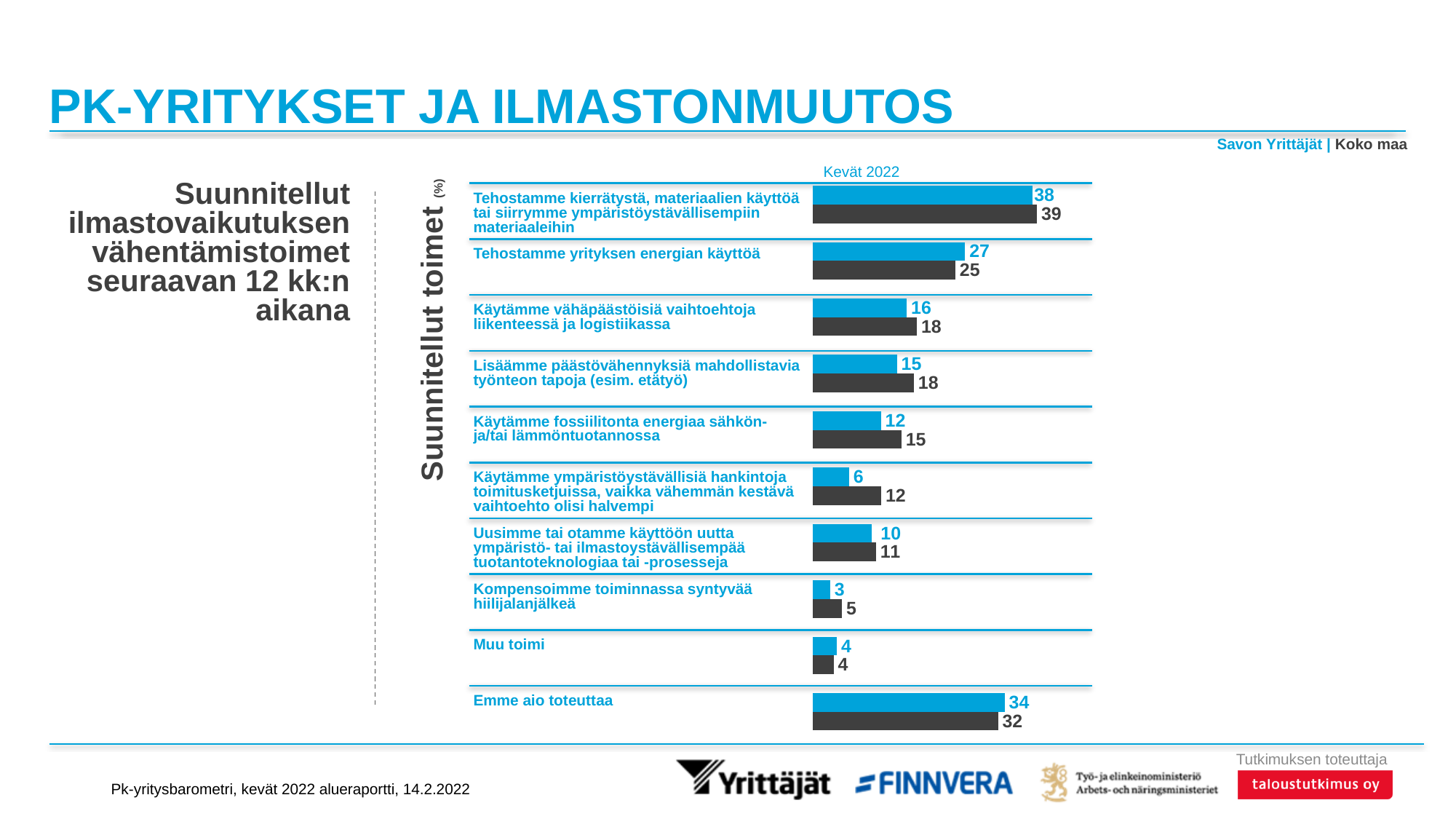
What is the difference between the Koko maa and Savon Yrittäjät values for "Käytämme ympäristöystävällisiä hankintoja toimitusketjuissa, vaikka vähemmän kestävä vaihtoehto olisi halvempi"? 6 What kind of chart is shown on the slide? Bar chart How many series does the chart show? 2 For "Emme aio toteuttaa", which is larger: Savon Yrittäjät or Koko maa? Savon Yrittäjät What is the value for Koko maa for "Kompensoimme toiminnassa syntyvää hiilijalanjälkeä"? 5 Which colour represents Savon Yrittäjät in the chart? Blue What is the value for Savon Yrittäjät for "Tehostamme yrityksen energian käyttöä"? 27 For "Käytämme fossiilitonta energiaa sähkön- ja/tai lämmöntuotannossa", which is larger: Savon Yrittäjät or Koko maa? Koko maa Which category has the highest value for Koko maa? Tehostamme kierrätystä, materiaalien käyttöä tai siirrymme ympäristöystävällisempiin materiaaleihin What is the value for Koko maa for "Emme aio toteuttaa"? 32 How many categories are shown in the chart? 10 Which category has the lowest value for Savon Yrittäjät? Kompensoimme toiminnassa syntyvää hiilijalanjälkeä